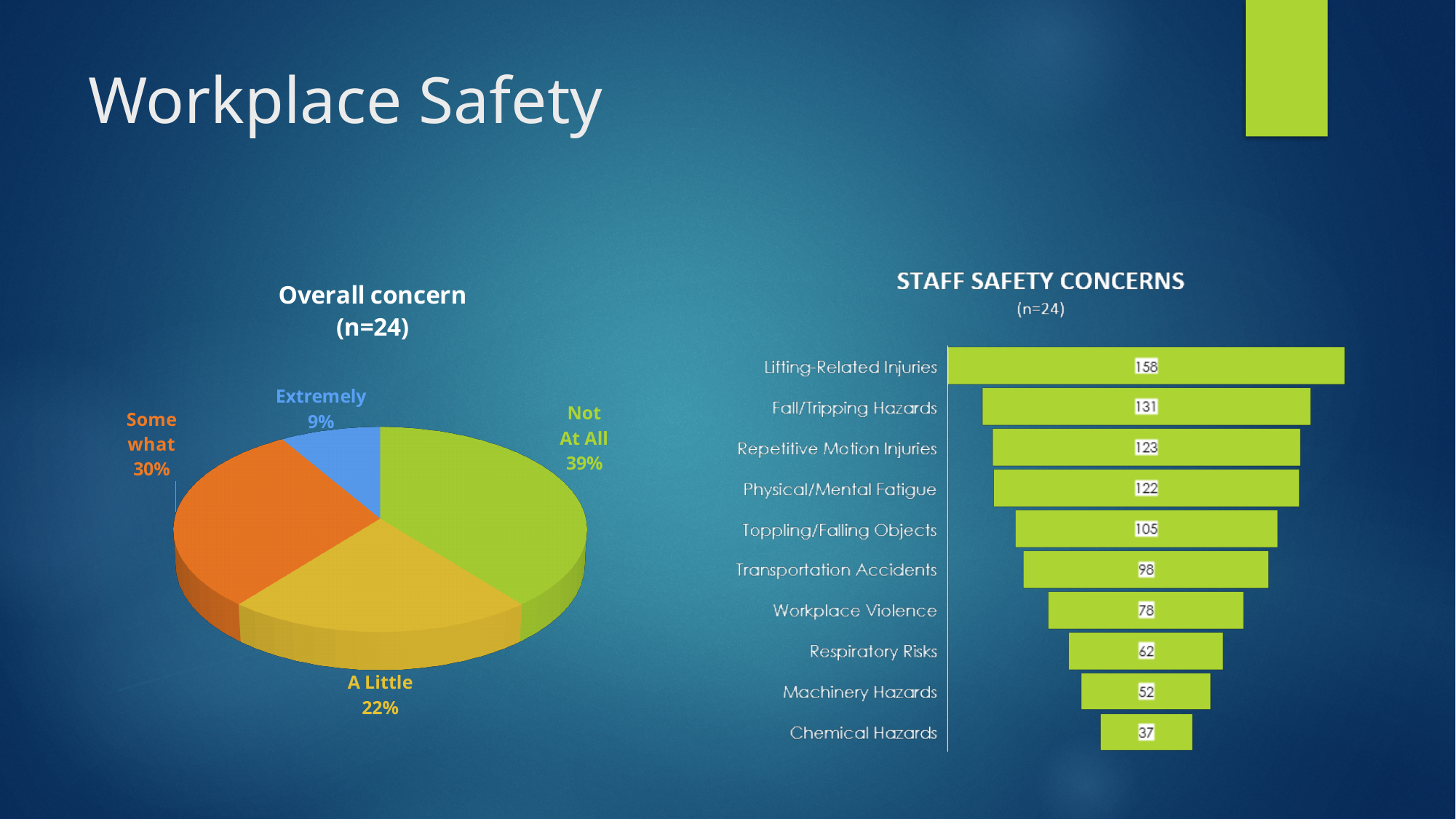
In the 'Overall concern (n=24)' pie chart, what share is labelled 'Extremely'? 9% In the 'Overall concern (n=24)' pie chart, which category has the smallest slice? Extremely In the 'Overall concern (n=24)' pie chart, what is the difference between the 'Some what' and 'A Little' shares? 8% In the 'STAFF SAFETY CONCERNS' chart, which category has the lowest value? Chemical Hazards In the 'Overall concern (n=24)' pie chart, which category has the largest slice? Not At All In the 'Overall concern (n=24)' pie chart, what share is labelled 'Not At All'? 39% In the 'STAFF SAFETY CONCERNS' chart, what is the value for Machinery Hazards? 52 In the 'STAFF SAFETY CONCERNS' chart, what is the difference between Lifting-Related Injuries and Fall/Tripping Hazards? 27 In the 'STAFF SAFETY CONCERNS' chart, which category has the highest value? Lifting-Related Injuries In the 'Overall concern (n=24)' pie chart, how many slices are there? 4 In the 'STAFF SAFETY CONCERNS' chart, how many categories are shown? 10 In the 'STAFF SAFETY CONCERNS' chart, what is the value for Toppling/Falling Objects? 105